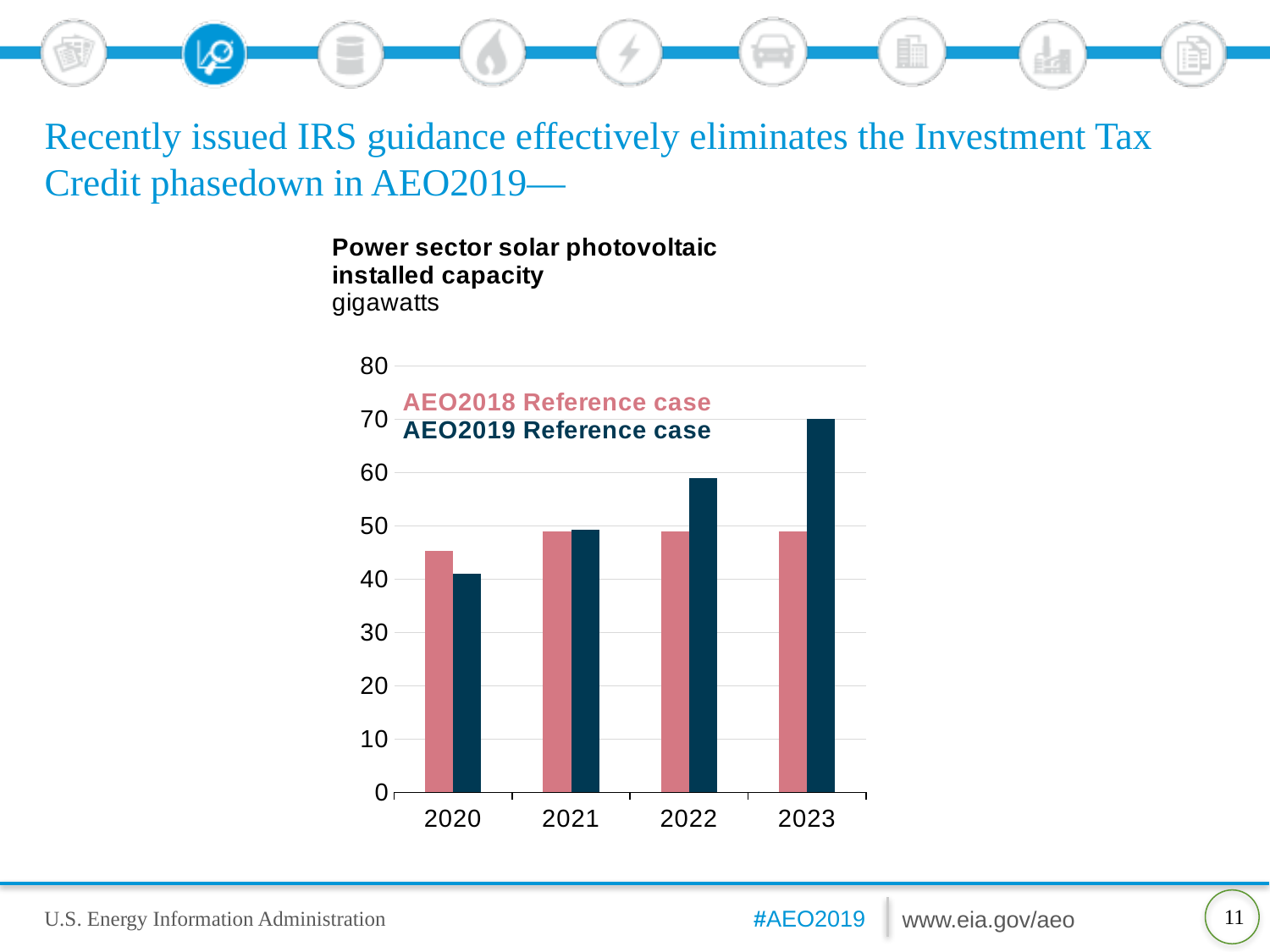
What unit is the installed capacity measured in? gigawatts In 2020, which is larger: the AEO2018 Reference case or the AEO2019 Reference case? AEO2018 Reference case Is the AEO2019 Reference case value for 2023 greater or less than 60? greater In which year is the AEO2019 Reference case value lowest? 2020 In 2023, which is larger: the AEO2018 Reference case or the AEO2019 Reference case? AEO2019 Reference case What kind of chart is shown on the slide? bar chart How many years are shown on the x axis of the chart? 4 Which series is shown in dark blue? AEO2019 Reference case In which year is the AEO2019 Reference case value highest? 2023 How many series does the chart show? 2 Is the AEO2019 Reference case value for 2020 greater or less than 50? less Does the AEO2019 Reference case value rise or fall from 2020 to 2023? rise